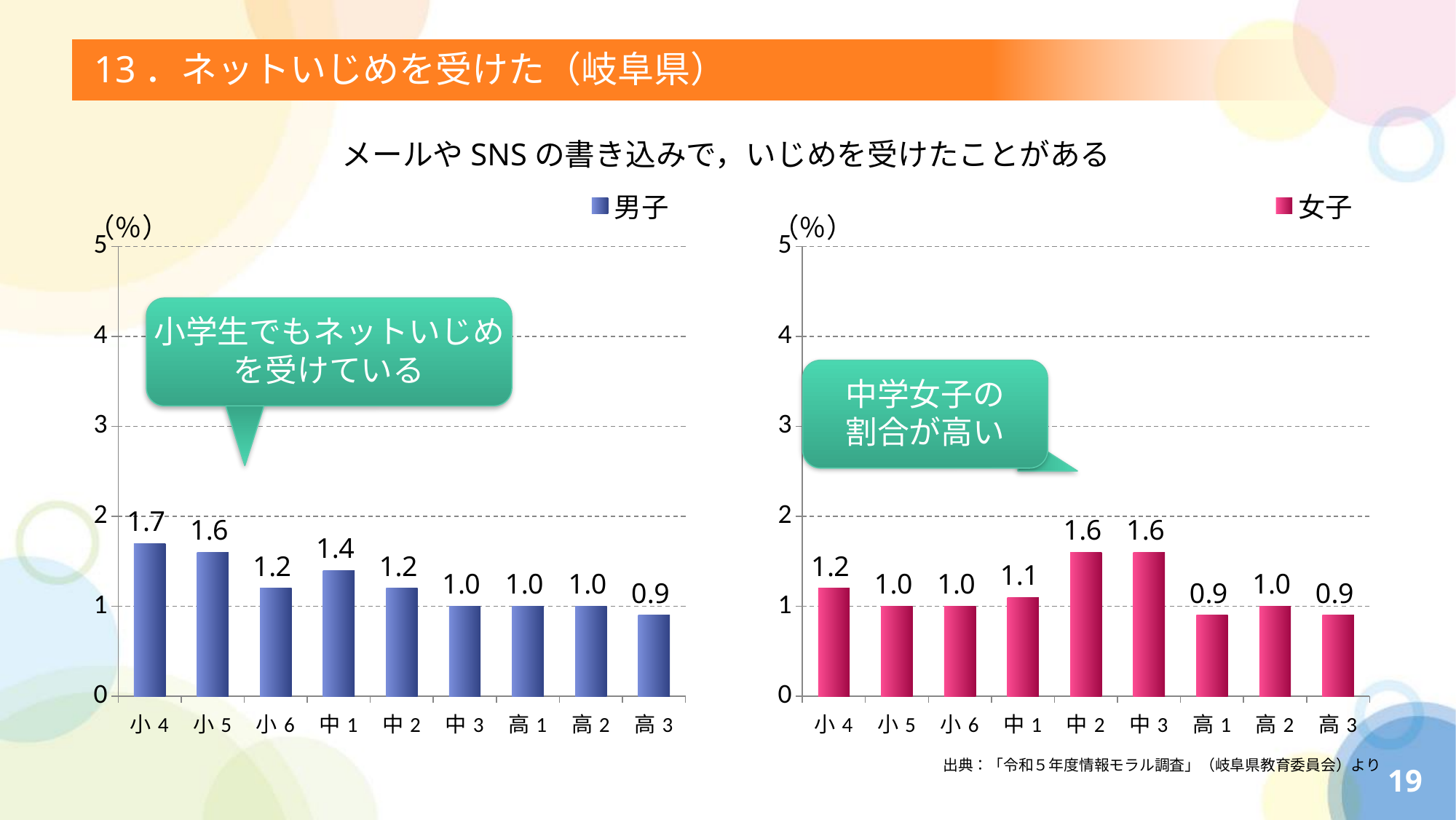
What kind of chart is the left chart (男子)? bar chart How many categories are shown on the x axis of the right chart (女子)? 9 In the left chart (男子), which category has the lowest value? 高3 What is the legend entry for the right chart? 女子 In the left chart (男子), what is the value for 小4? 1.7 In the left chart (男子), what is the difference between the values for 小4 and 小6? 0.5 In the right chart (女子), which is larger, the value for 小4 or the value for 中1? 小4 In the left chart (男子), do the values generally rise or fall from 小4 to 高3? fall In the left chart (男子), which category has the highest value? 小4 In the right chart (女子), what is the difference between the values for 中2 and 高1? 0.7 In the left chart (男子), is the value for 中1 greater or less than 1? greater In the right chart (女子), what is the value for 中3? 1.6